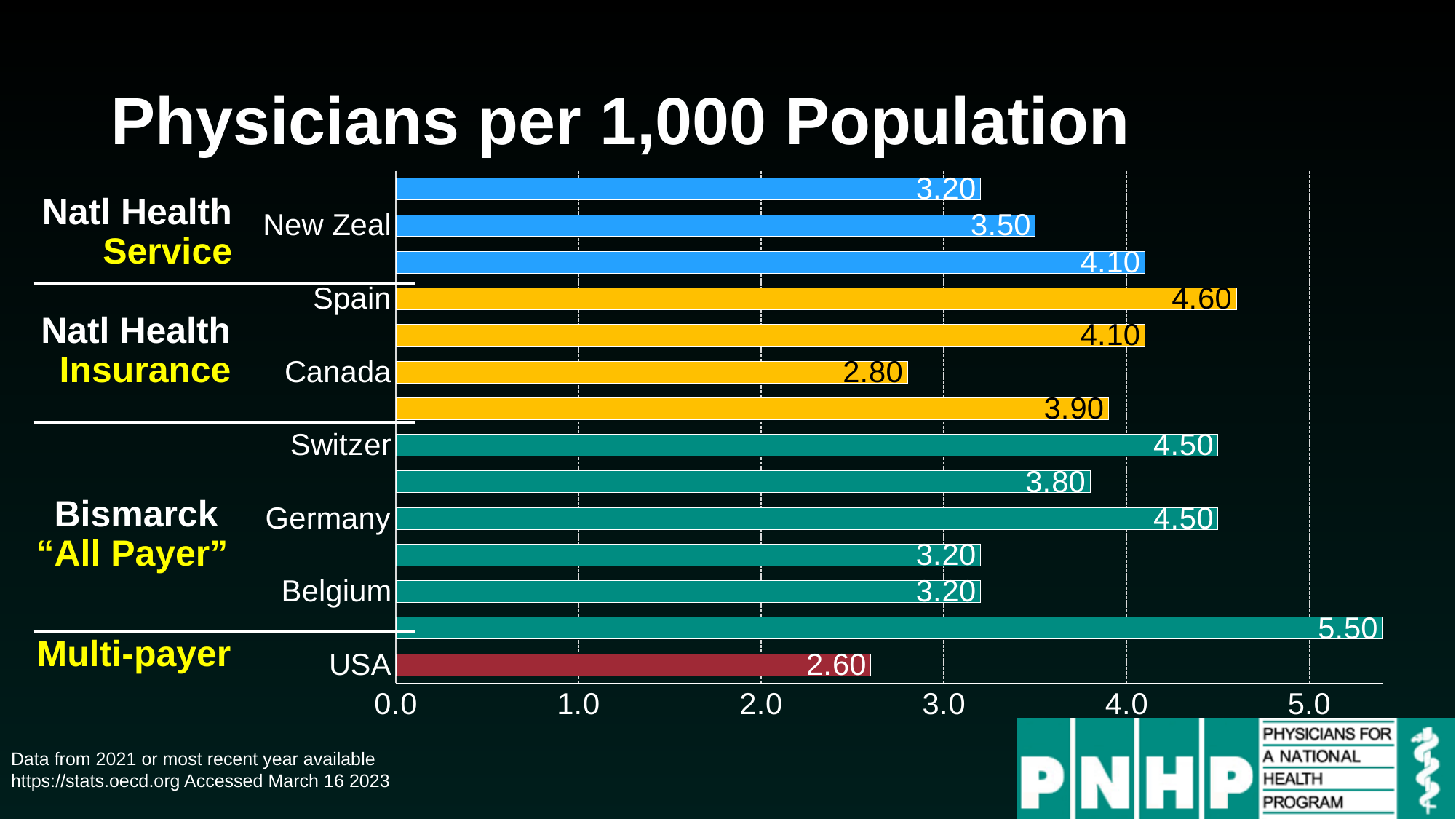
What is the value for Germany? 4.50 What is the title of the chart? Physicians per 1,000 Population Which has a higher value, Canada or Belgium? Belgium What is the value for Canada? 2.80 How many bars are plotted in the chart? 14 Is the value for Switzerland greater or less than 4.0? greater What is the difference between the values for Spain and the USA? 2.00 Which labelled country has the lowest number of physicians per 1,000 population? USA What is the value for the USA? 2.60 What is the value for Spain? 4.60 What kind of chart is shown on the slide? bar chart What is the value for Belgium? 3.20